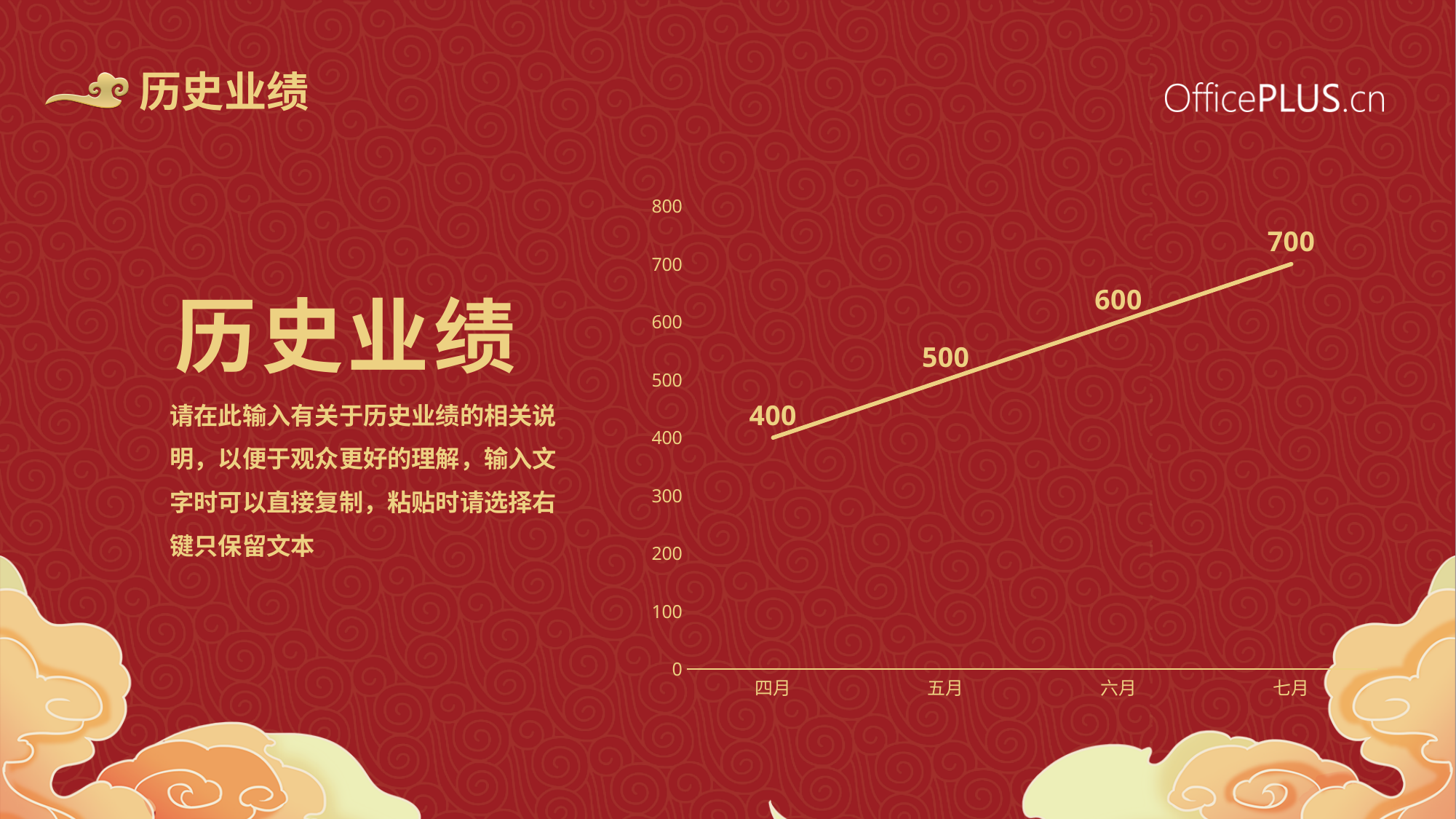
Which is larger, the value for 五月 or the value for 六月? 六月 What kind of chart is shown on the slide? line chart What is the value for 六月? 600 What is the difference between the values for 七月 and 四月? 300 Which month has the lowest value? 四月 Which month has the highest value? 七月 Do the values rise or fall from 四月 to 七月? rise How many months are plotted on the chart? 4 What is the value for 五月? 500 Is the value for 六月 greater or less than 500? greater What is the value for 七月? 700 What is the value for 四月? 400